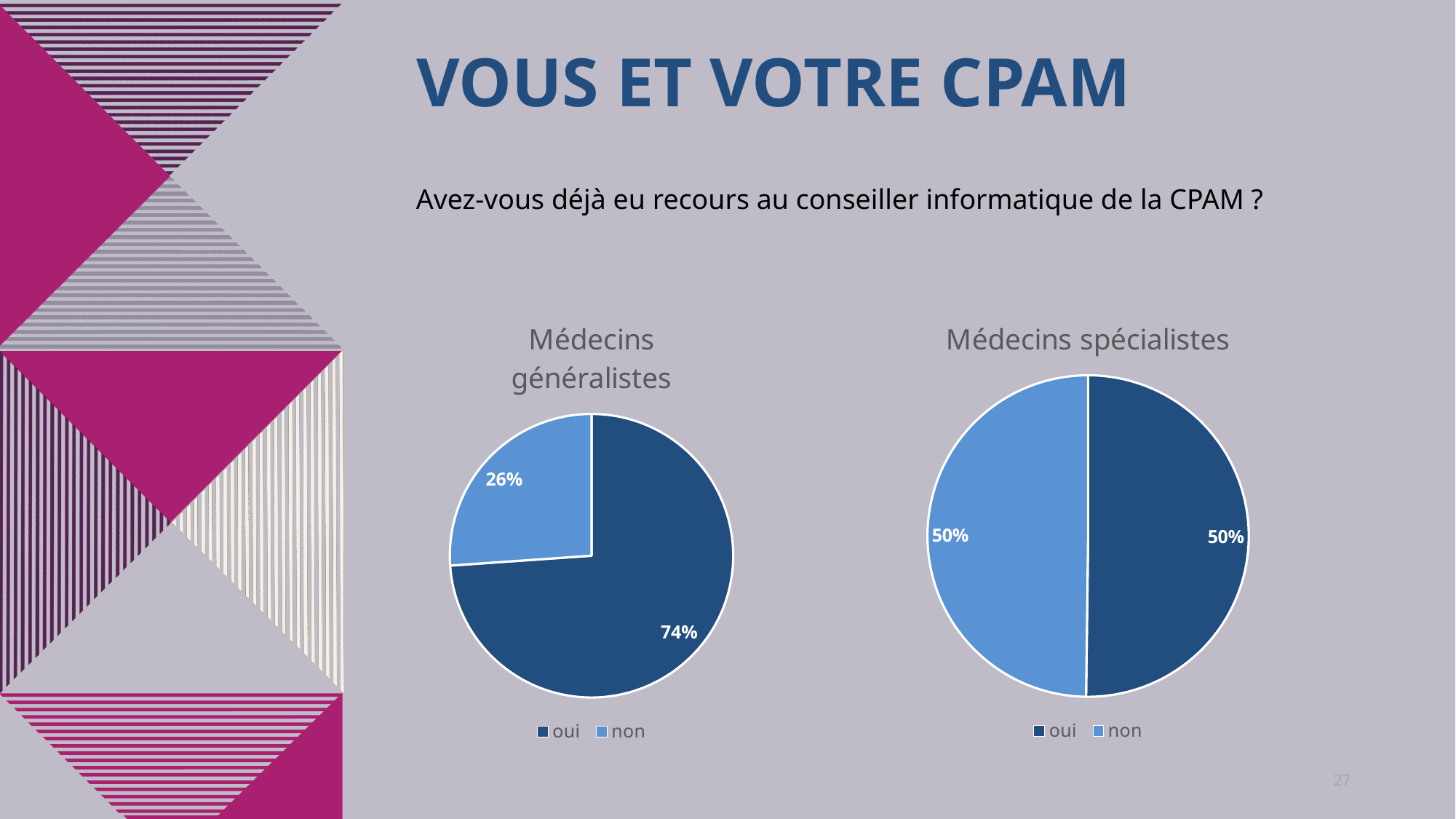
In the 'Médecins spécialistes' chart, what share of respondents answered 'oui'? 50% In the 'Médecins généralistes' chart, what share of respondents answered 'oui'? 74% What is the title of the pie chart on the right of the slide? Médecins spécialistes In the 'Médecins généralistes' chart, what is the difference between the 'oui' and 'non' shares? 48% What kind of chart is the 'Médecins spécialistes' chart? pie chart In the 'Médecins généralistes' chart, which answer has the smallest slice? non In the 'Médecins spécialistes' chart, which colour represents 'non'? light blue How many entries does the legend of the 'Médecins spécialistes' chart list? 2 How many slices does the 'Médecins généralistes' pie chart have? 2 In the 'Médecins généralistes' chart, what share of respondents answered 'non'? 26% In the 'Médecins généralistes' chart, which answer has the largest slice? oui In the 'Médecins généralistes' chart, is the 'oui' slice larger or smaller than the 'non' slice? larger